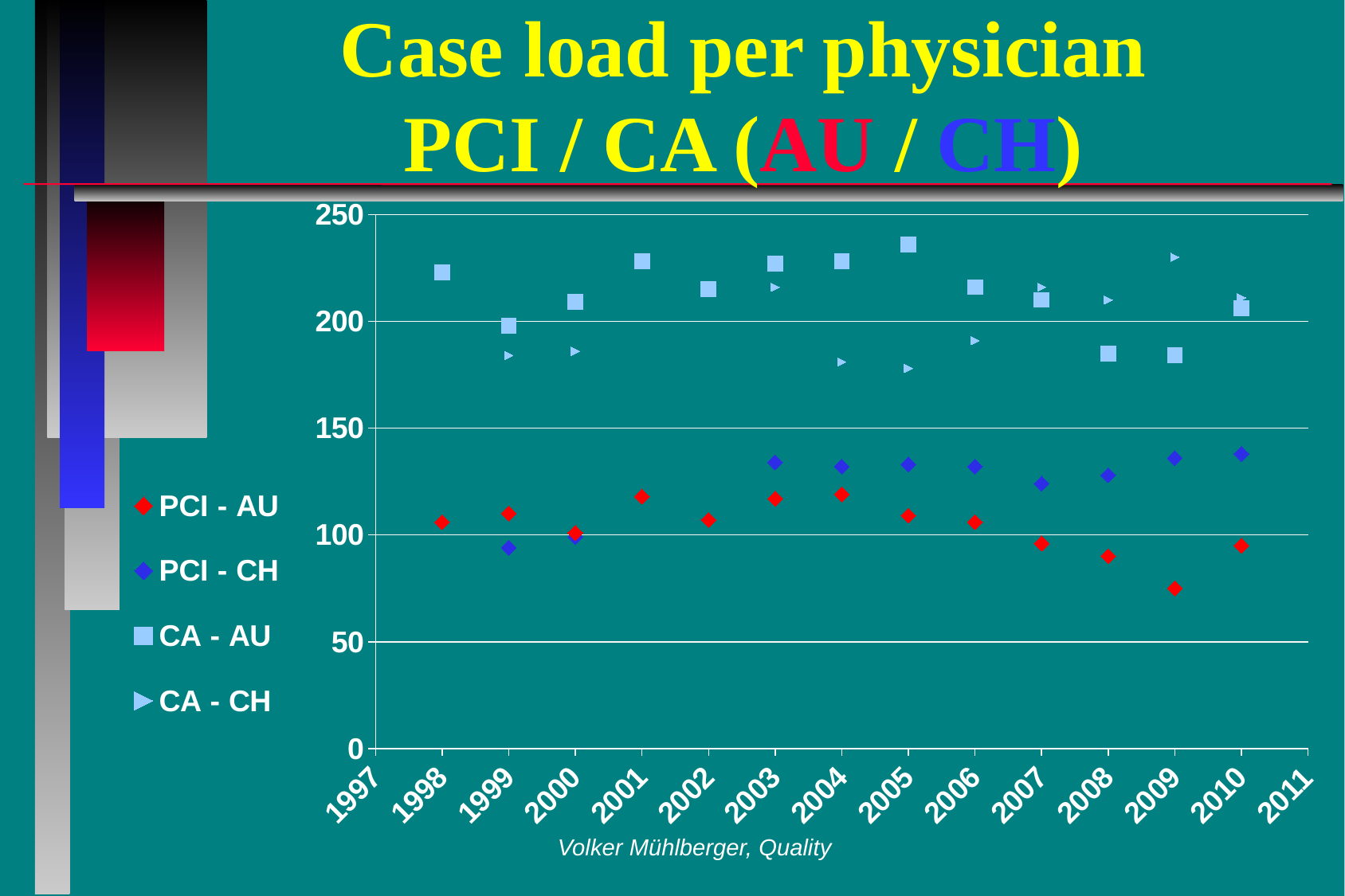
Is the value for PCI - AU in 2009 greater or less than 100? less Is the value for CA - AU in 2008 greater or less than 200? less Do the PCI - AU values rise or fall from 2004 to 2009? fall In 2009, which is larger: CA - CH or CA - AU? CA - CH In which year is the PCI - AU value lowest? 2009 In which year is the CA - AU value highest? 2005 In 2010, which is larger: PCI - CH or PCI - AU? PCI - CH What marker shape is used for the CA - AU series in the legend? square Is the value for PCI - CH in 2010 greater or less than 150? less How many series does the legend list? 4 What kind of chart is shown on the slide? scatter chart